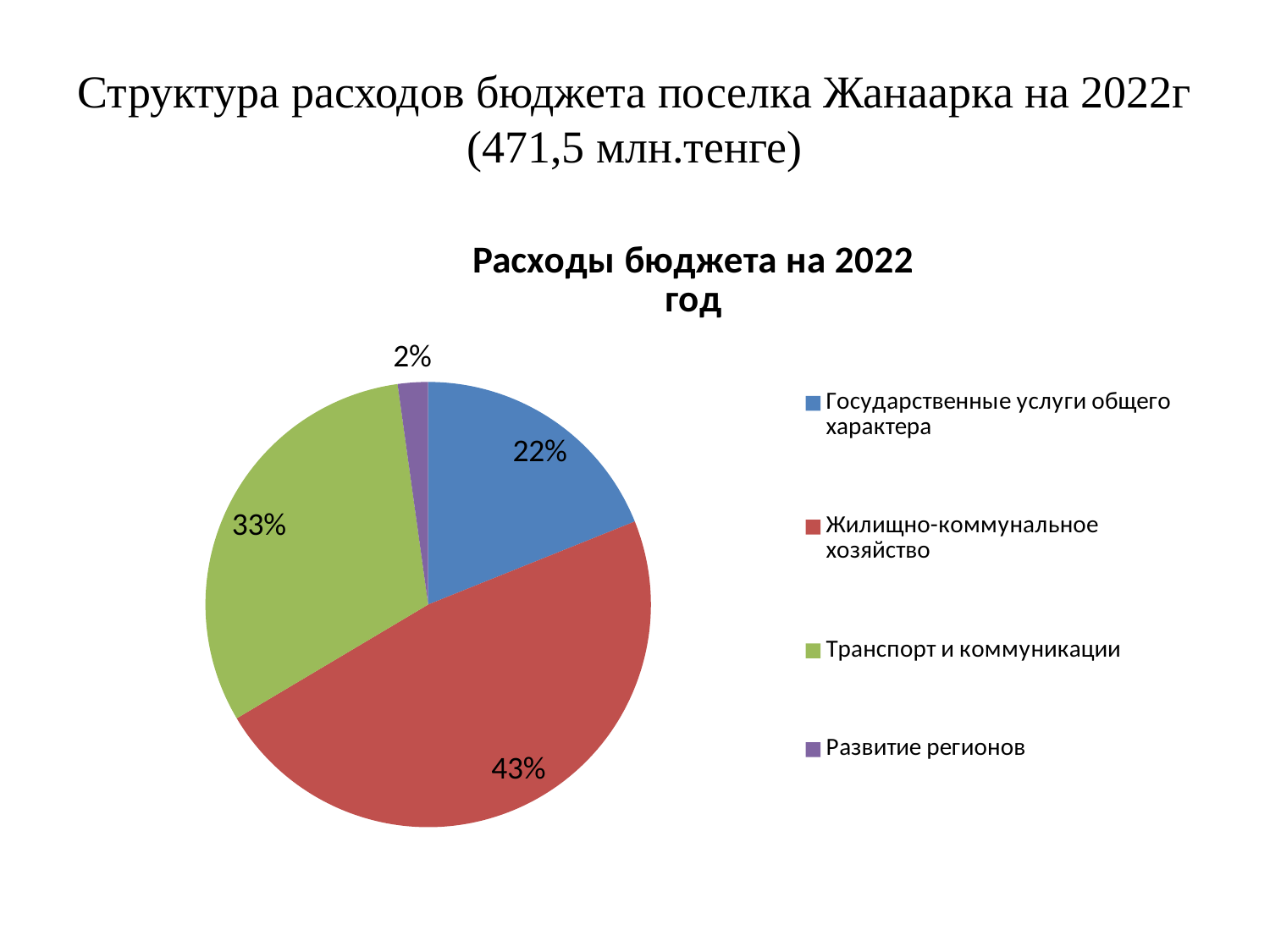
What share of the pie is Транспорт и коммуникации? 33% What share of the pie is Развитие регионов? 2% What kind of chart is shown on the slide? pie chart What share of the pie is Государственные услуги общего характера? 22% Which is larger: the share for Транспорт и коммуникации or the share for Государственные услуги общего характера? Транспорт и коммуникации What colour is the slice for Транспорт и коммуникации? green Which category has the smallest share of the pie? Развитие регионов What is the difference in percentage points between Жилищно-коммунальное хозяйство and Транспорт и коммуникации? 10 How many slices does the pie chart have? 4 Which category has the largest share of the pie? Жилищно-коммунальное хозяйство What is the title of the chart? Расходы бюджета на 2022 год